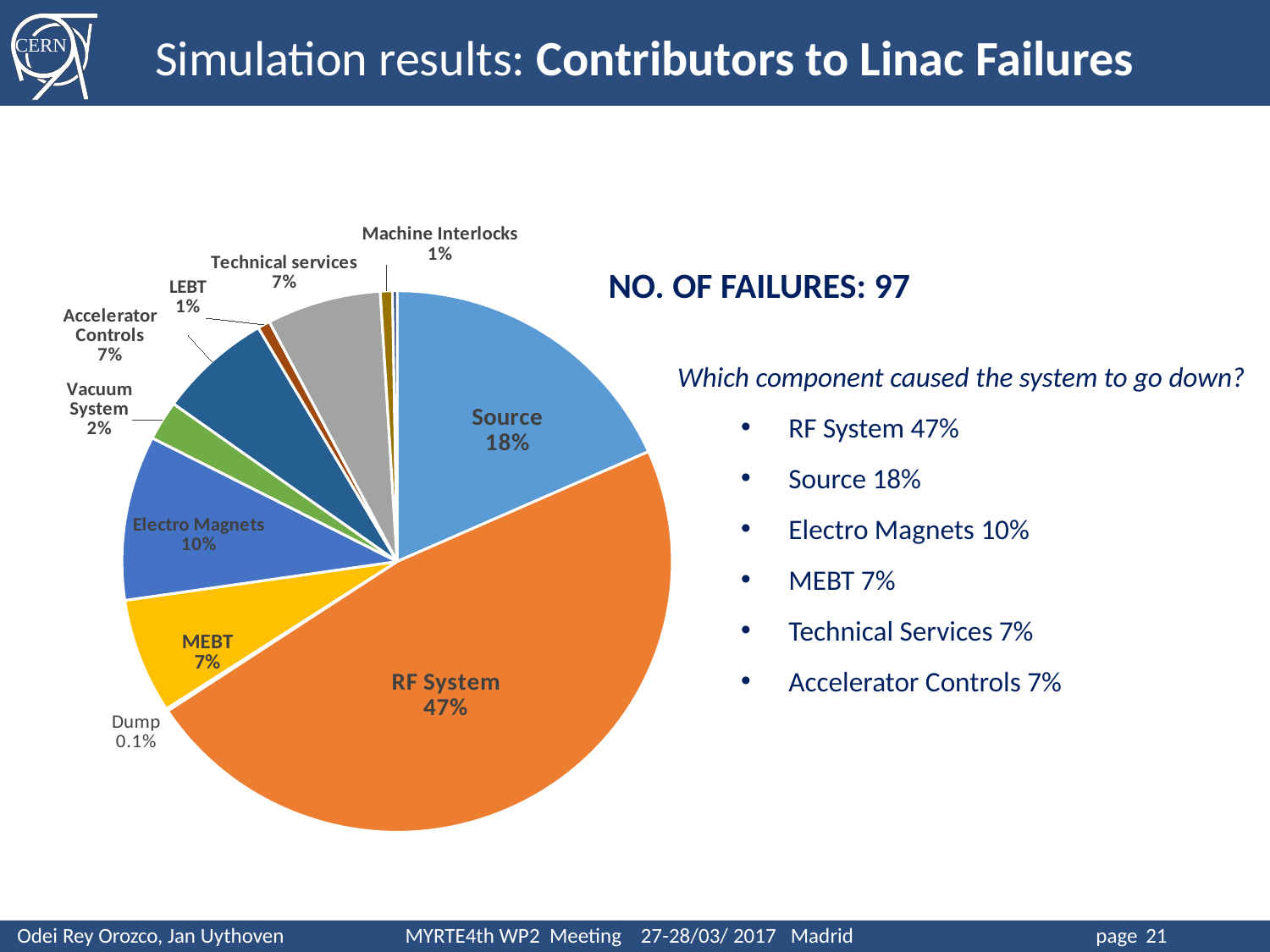
Which component is the largest contributor to Linac failures in the pie chart? RF System What share of Linac failures is attributed to the Vacuum System? 2% What share of Linac failures is attributed to the Dump? 0.1% What is the total number of failures stated on the slide? 97 How many slices does the pie chart have? 11 What is the difference in share between the RF System and the Source? 29% What kind of chart is shown on the slide? pie chart Which has a larger share of failures, Electro Magnets or MEBT? Electro Magnets What share of Linac failures is attributed to the Source? 18% Which component is the smallest contributor to Linac failures in the pie chart? Dump